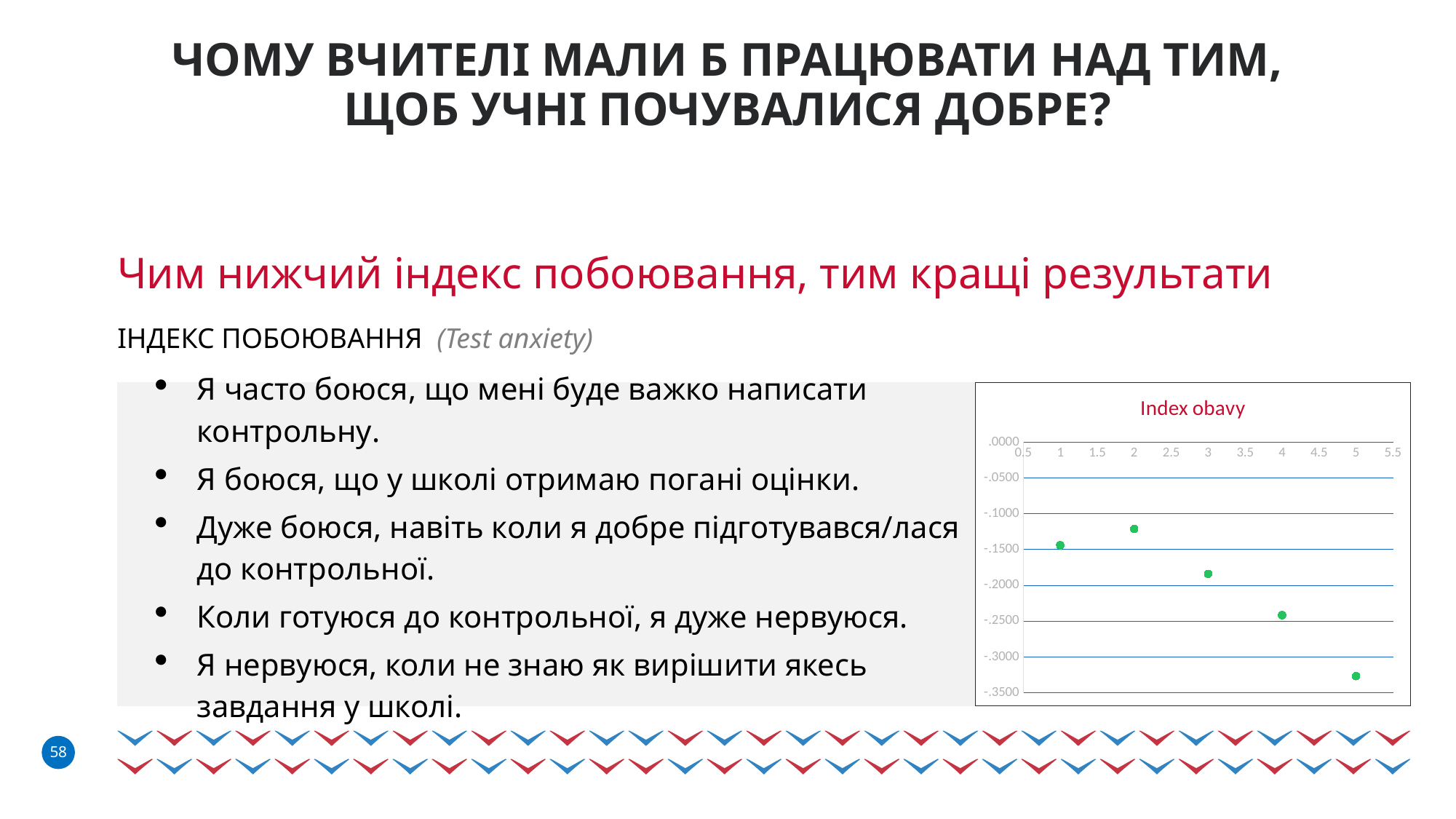
What kind of chart is shown on the slide? scatter chart How many data points are plotted in the chart? 5 What is the title of the chart? Index obavy Is the value of the point at x = 2 greater or less than -.1500? greater Do the plotted values generally rise or fall as x increases from 2 to 5? fall What colour are the plotted points? green Is the value of the point at x = 3 greater or less than -.1500? less Which point has the larger value, the one at x = 3 or the one at x = 4? x = 3 At which x value is the highest plotted point? 2 At which x value is the lowest plotted point? 5 Is the value of the point at x = 5 greater or less than -.3000? less